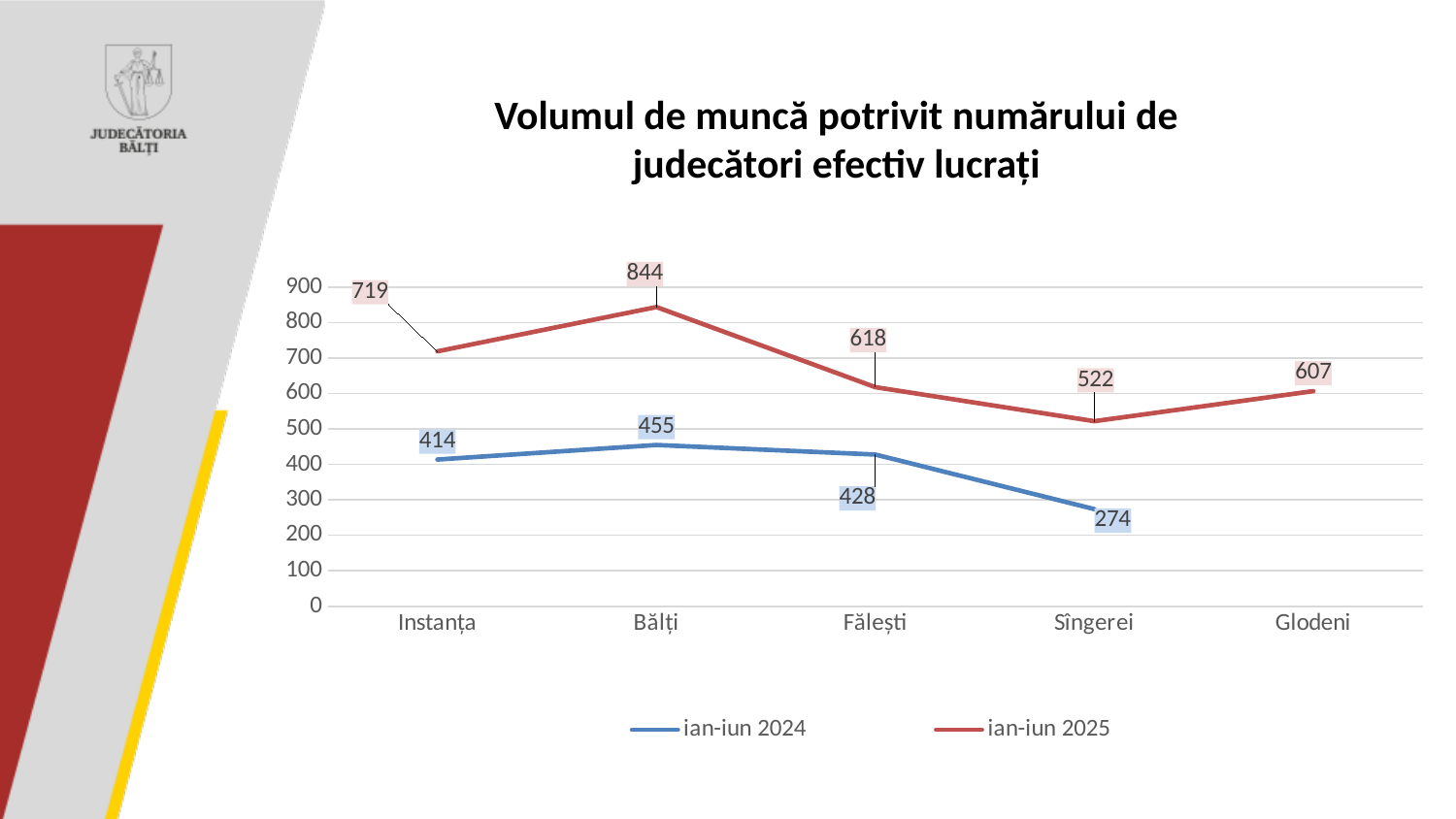
Which category has the highest value in the ian-iun 2025 series? Bălți What is the value for Sîngerei in the ian-iun 2024 series? 274 How many series does the legend list? 2 What is the value for Bălți in the ian-iun 2025 series? 844 What type of chart is shown on the slide? line chart Which series is drawn in red? ian-iun 2025 What is the difference between the ian-iun 2025 and ian-iun 2024 values for Instanța? 305 Which category has the lowest value in the ian-iun 2024 series? Sîngerei Is the ian-iun 2025 value for Sîngerei greater or less than 500? greater What is the value for Glodeni in the ian-iun 2025 series? 607 How many categories are shown on the x axis? 5 Which is larger: the ian-iun 2024 value for Bălți or the ian-iun 2024 value for Fălești? Bălți